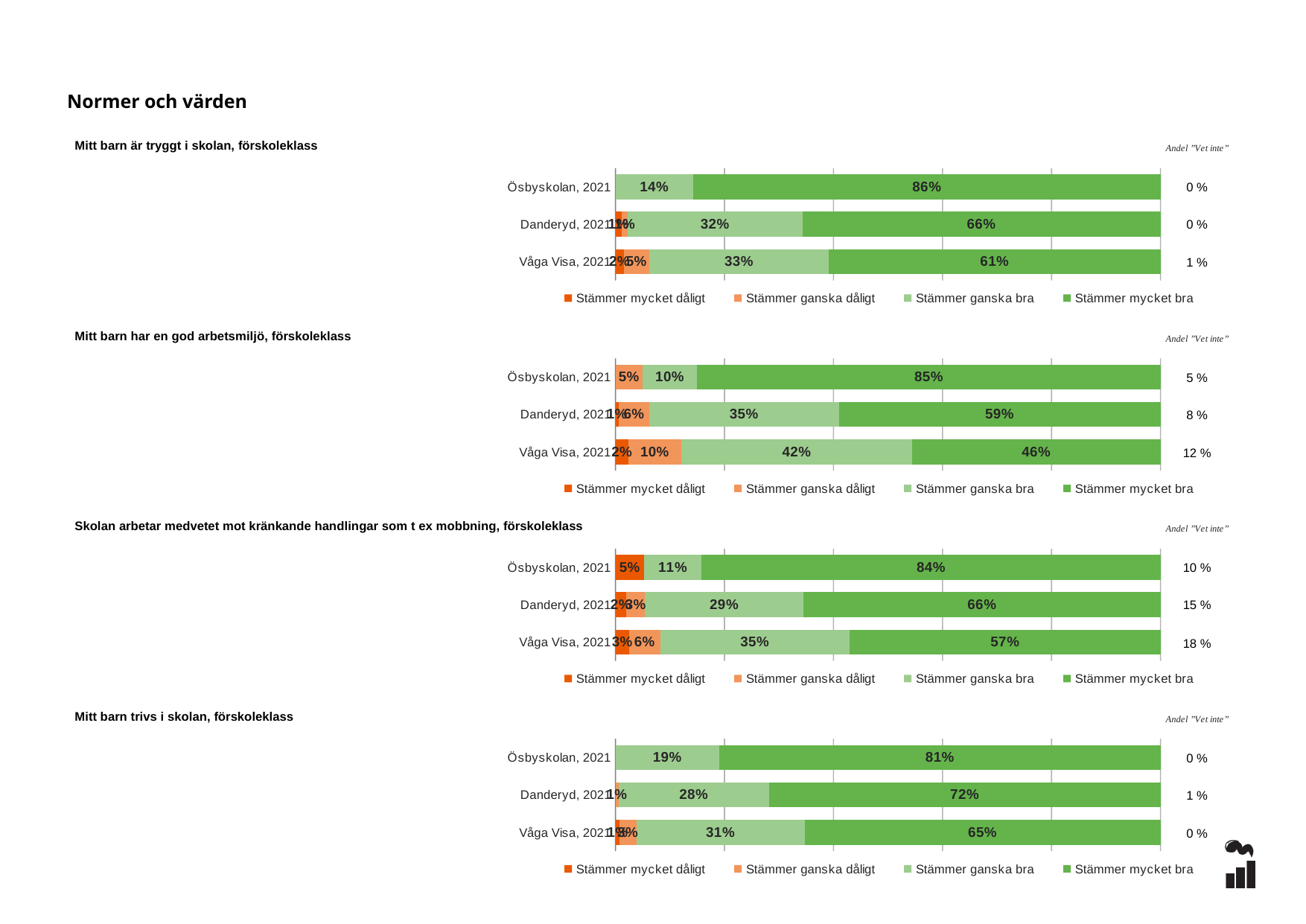
In the chart "Mitt barn trivs i skolan, förskoleklass", is the "Stämmer mycket bra" value for Danderyd, 2021 larger or smaller than for Våga Visa, 2021? larger In the chart "Skolan arbetar medvetet mot kränkande handlingar som t ex mobbning, förskoleklass", what is the value of "Stämmer mycket dåligt" for Ösbyskolan, 2021? 5% In the chart "Skolan arbetar medvetet mot kränkande handlingar som t ex mobbning, förskoleklass", which row has the lowest value for "Stämmer mycket bra"? Våga Visa, 2021 In the chart "Mitt barn har en god arbetsmiljö, förskoleklass", what is the difference between the "Stämmer mycket bra" values for Ösbyskolan, 2021 and Danderyd, 2021? 26 percentage points What kind of chart is "Mitt barn är tryggt i skolan, förskoleklass"? Stacked bar chart In the chart "Skolan arbetar medvetet mot kränkande handlingar som t ex mobbning, förskoleklass", what is the "Andel Vet inte" share for Våga Visa, 2021? 18 % In the chart "Mitt barn trivs i skolan, förskoleklass", what is the value of "Stämmer ganska bra" for Ösbyskolan, 2021? 19% How many series does the legend of the chart "Mitt barn trivs i skolan, förskoleklass" list? 4 In the chart "Mitt barn är tryggt i skolan, förskoleklass", what is the value of "Stämmer mycket bra" for Ösbyskolan, 2021? 86% In the chart "Mitt barn är tryggt i skolan, förskoleklass", what is the value of "Stämmer ganska bra" for Våga Visa, 2021? 33% In the chart "Mitt barn har en god arbetsmiljö, förskoleklass", which row has the highest value for "Stämmer mycket bra"? Ösbyskolan, 2021 In the chart "Mitt barn har en god arbetsmiljö, förskoleklass", what is the value of "Stämmer ganska dåligt" for Våga Visa, 2021? 10%